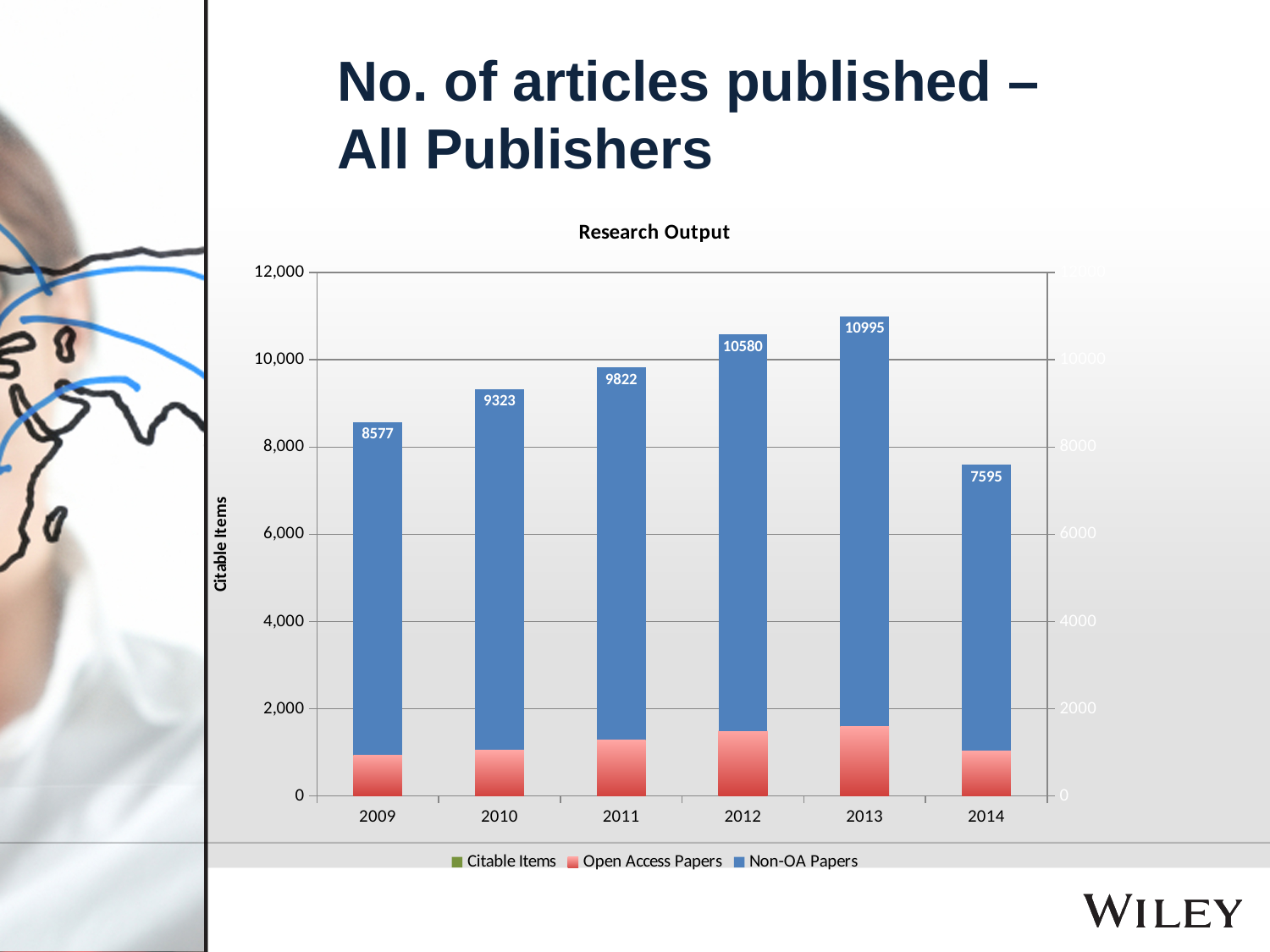
Which year has the highest labelled value? 2013 What is the title of the chart? Research Output Which year has the lowest labelled value? 2014 What kind of chart is shown on the slide? stacked bar chart What value is labelled on the bar for 2009? 8577 What value is labelled on the bar for 2013? 10995 What value is labelled on the bar for 2014? 7595 How many series does the legend list? 3 How many years are shown on the x axis? 6 What is the difference between the labelled values for 2012 and 2011? 758 Which is larger, the labelled value for 2010 or for 2011? 2011 Is the Open Access Papers value for 2013 greater or less than 2,000? less